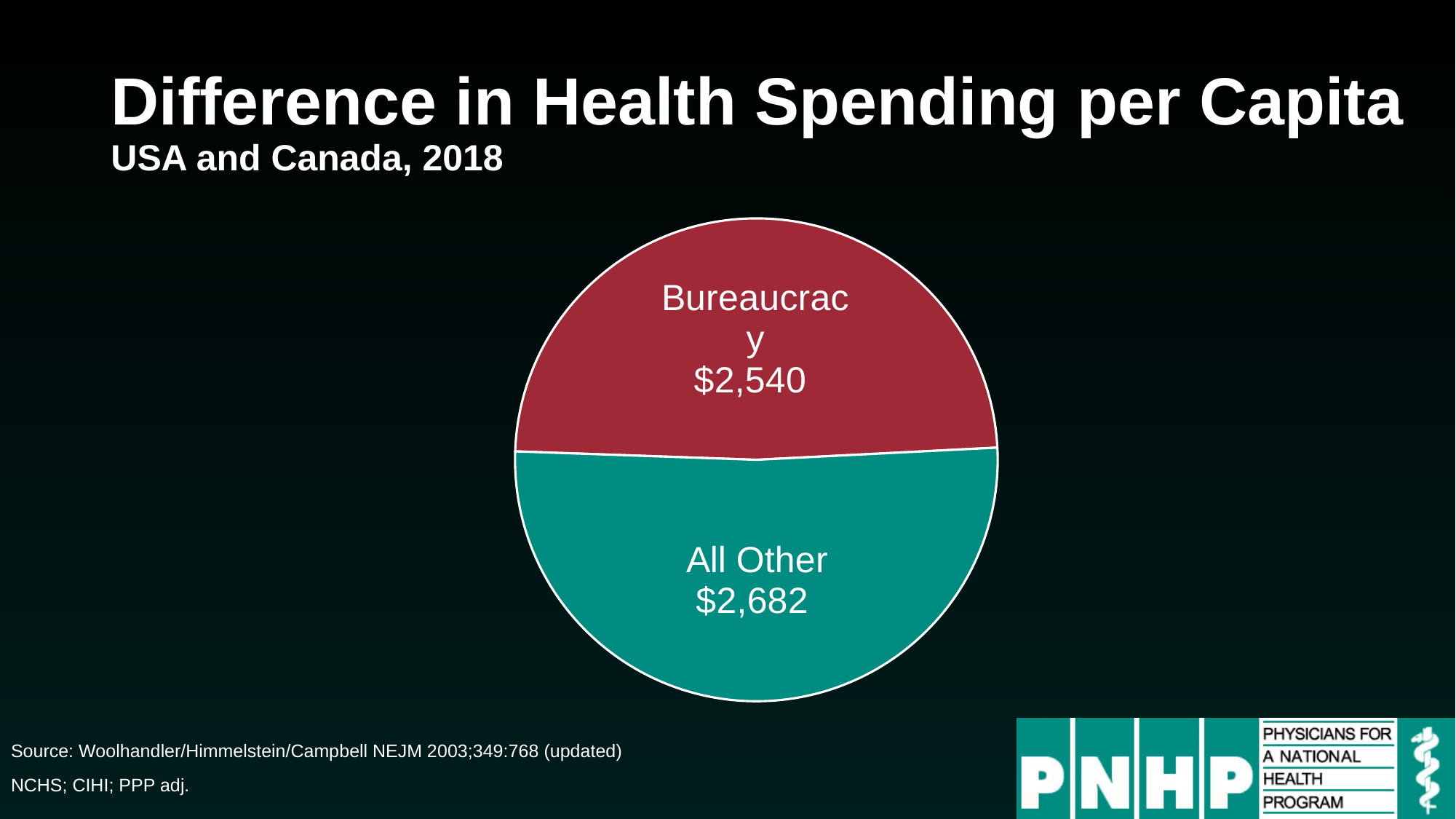
What is the total of the two slices in the pie chart? $5,222 How many slices does the pie chart have? 2 What is the value of the All Other slice in the pie chart? $2,682 Which slice of the pie chart has the smaller value? Bureaucracy What share of the pie does the Bureaucracy slice represent, to one decimal place? 48.6% Which slice of the pie chart has the larger value? All Other What kind of chart is shown on the slide? pie chart What is the value of the Bureaucracy slice in the pie chart? $2,540 What is the title of the chart on the slide? Difference in Health Spending per Capita What is the difference between the All Other value and the Bureaucracy value? $142 Is the value for Bureaucracy larger or smaller than the value for All Other? smaller What colour is the All Other slice of the pie chart? teal